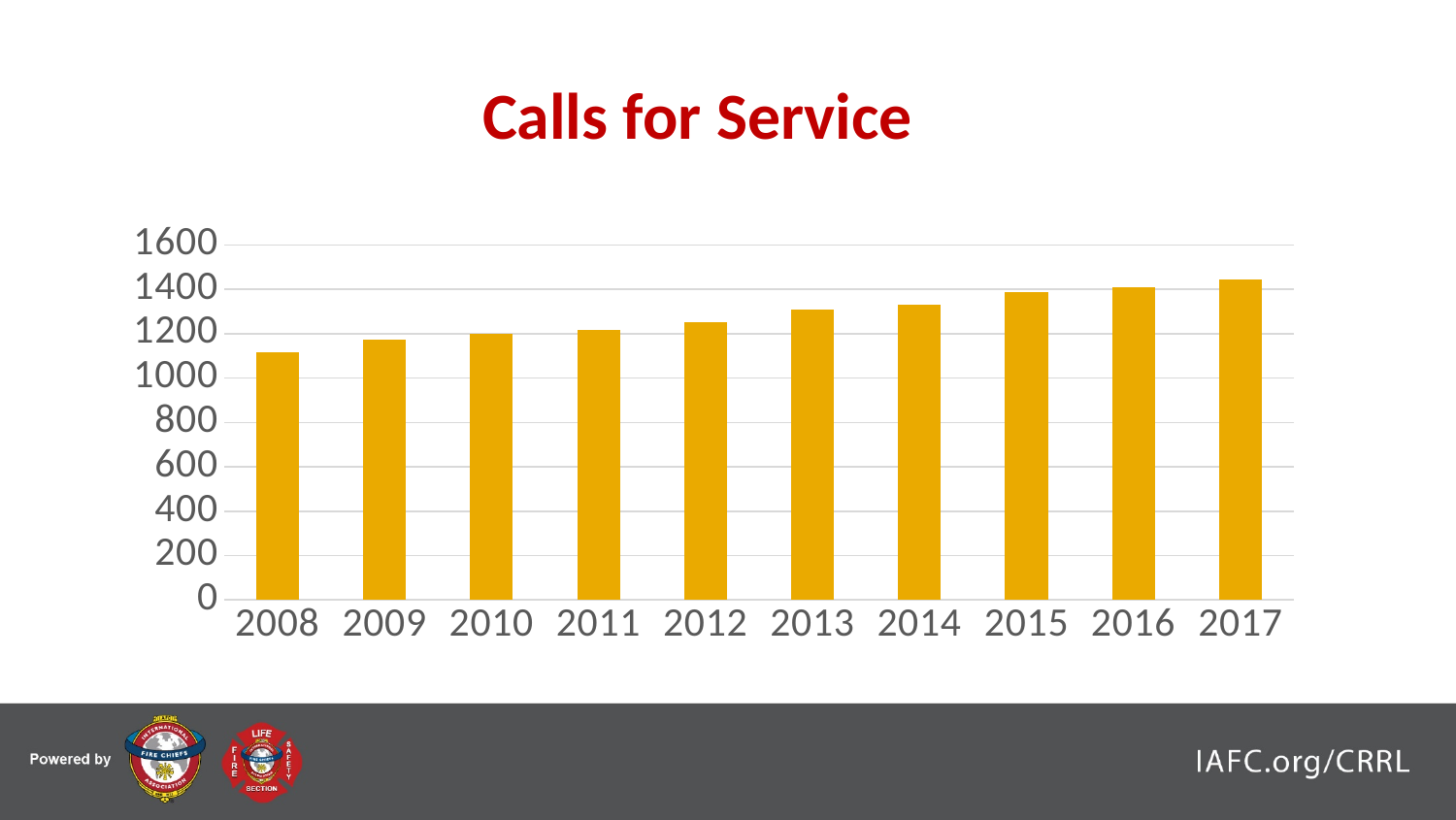
Which year has the highest number of calls for service? 2017 Which year has the lowest number of calls for service? 2008 What is the title of the chart? Calls for Service What kind of chart is shown on the slide? Bar chart Do the calls for service rise or fall from 2008 to 2017? Rise What colour are the bars in the chart? Yellow Is the value for 2013 greater or less than 1200? greater Is the value for 2017 greater or less than 1400? greater Which year has more calls for service, 2009 or 2016? 2016 How many years are shown on the x axis of the chart? 10 Is the value for 2008 greater or less than 1200? less